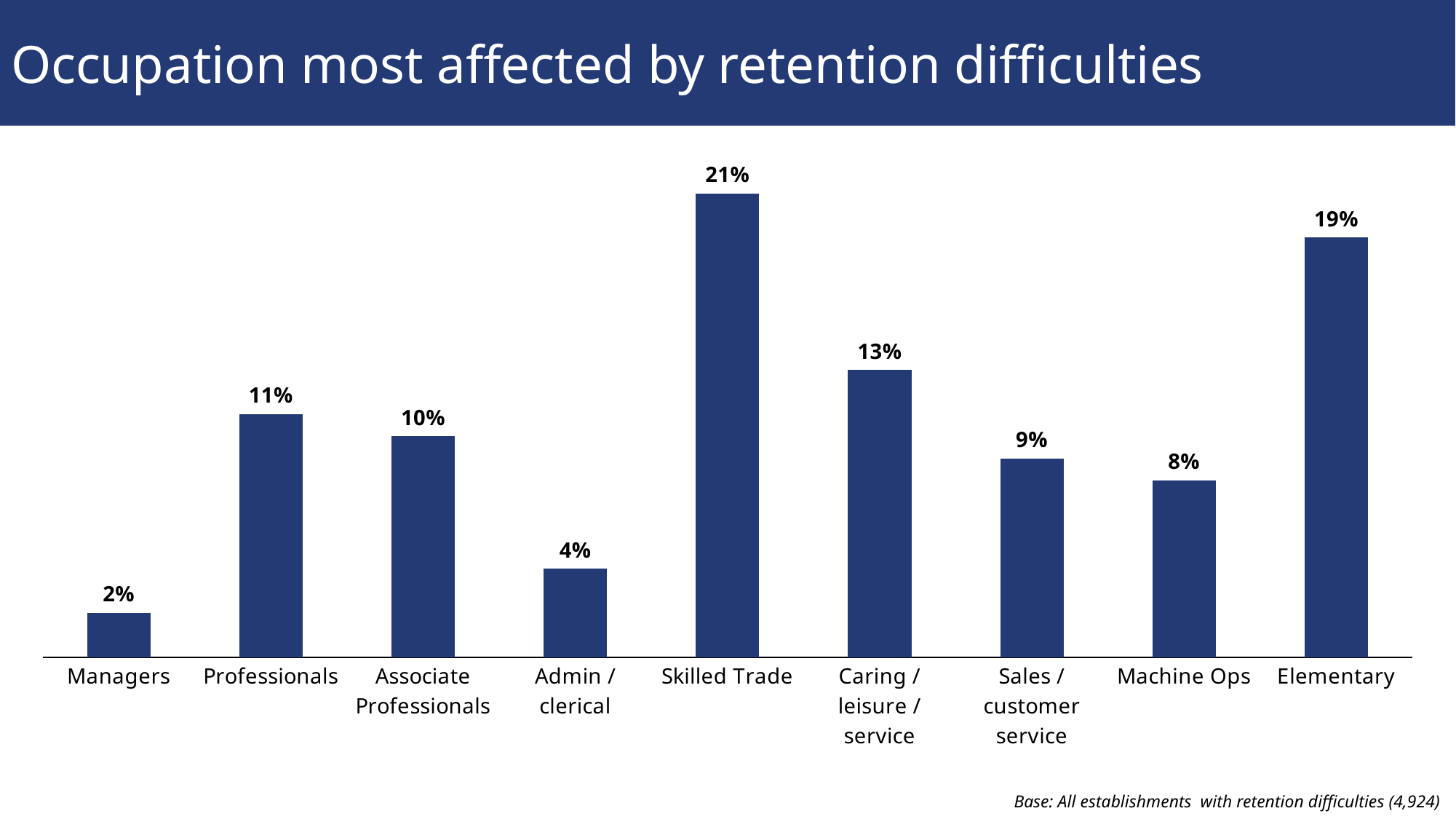
What is the value for Machine Ops? 8% What is the value for Skilled Trade? 21% What is the title of the slide? Occupation most affected by retention difficulties What is the value for Managers? 2% How many occupation categories are shown in the chart? 9 What kind of chart is shown on the slide? Bar chart What is the difference between the values for Professionals and Admin / clerical? 7% Which occupation has the highest value? Skilled Trade What is the difference between the values for Skilled Trade and Elementary? 2% Which is larger, the value for Sales / customer service or the value for Caring / leisure / service? Caring / leisure / service Which occupation has the lowest value? Managers What is the value for Caring / leisure / service? 13%